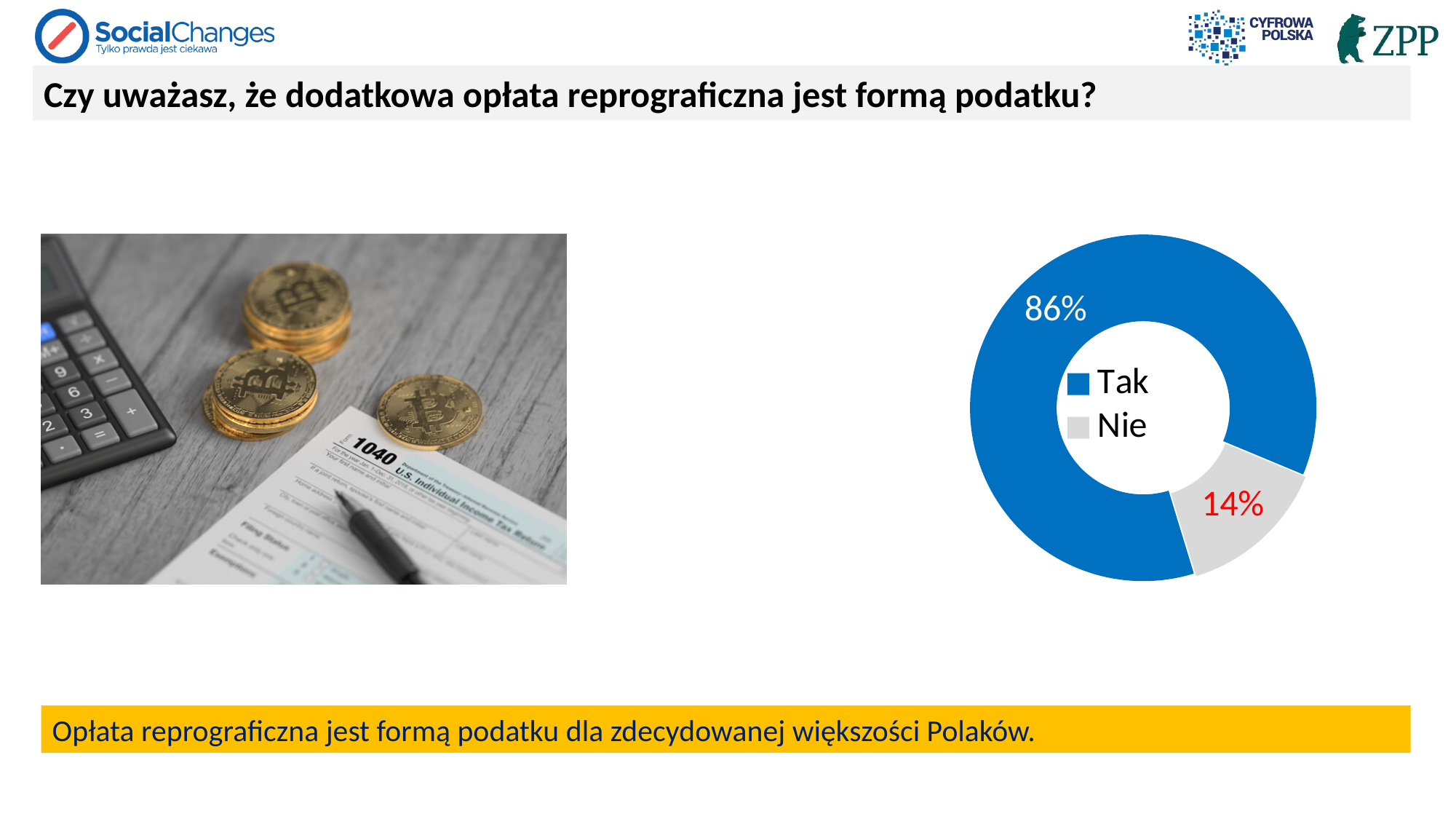
What percentage of respondents answered "Nie"? 14% Which answer has the smallest share of the chart? Nie Which is larger, the share for "Tak" or the share for "Nie"? Tak How many categories does the chart show? 2 Which answer has the largest share of the chart? Tak What is the difference in percentage points between the "Tak" and "Nie" shares? 72 What are the two legend entries of the chart? Tak, Nie What share of the pie does the "Nie" slice represent? 14% What percentage of respondents answered "Tak"? 86% What kind of chart is shown on the slide? Pie chart (doughnut) What colour is the "Tak" slice in the chart? Blue